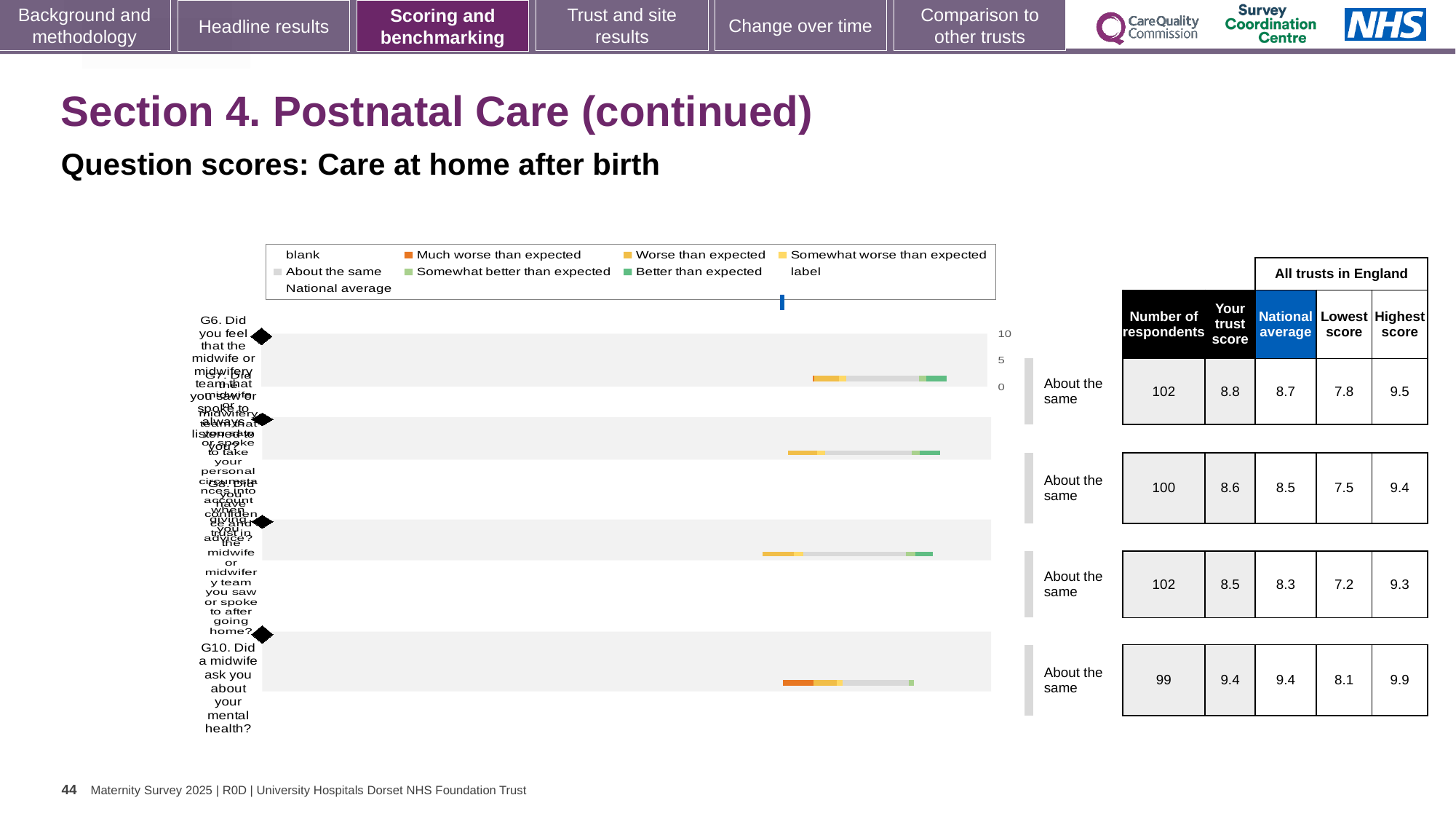
What is the lowest score across all trusts in England for question G10? 8.1 What is the highest score across all trusts in England for question G6? 9.5 What type of chart is used to show the question scores for care at home after birth? bar chart What is the lowest 'Your trust score' value shown in the table? 8.5 Which question has the highest 'Your trust score' in the table? G10 By how much does the trust score for G6 exceed the national average for G6? 0.1 What is the national average for question G10 (did a midwife ask you about your mental health)? 9.4 What benchmark category is shown next to each of the four questions? About the same How many respondents answered question G10? 99 What is 'Your trust score' for question G6 (midwife or midwifery team listened to you)? 8.8 Which is larger: the trust score for G6 or the trust score for G10? G10 How many questions (bars) are shown in the chart? 4